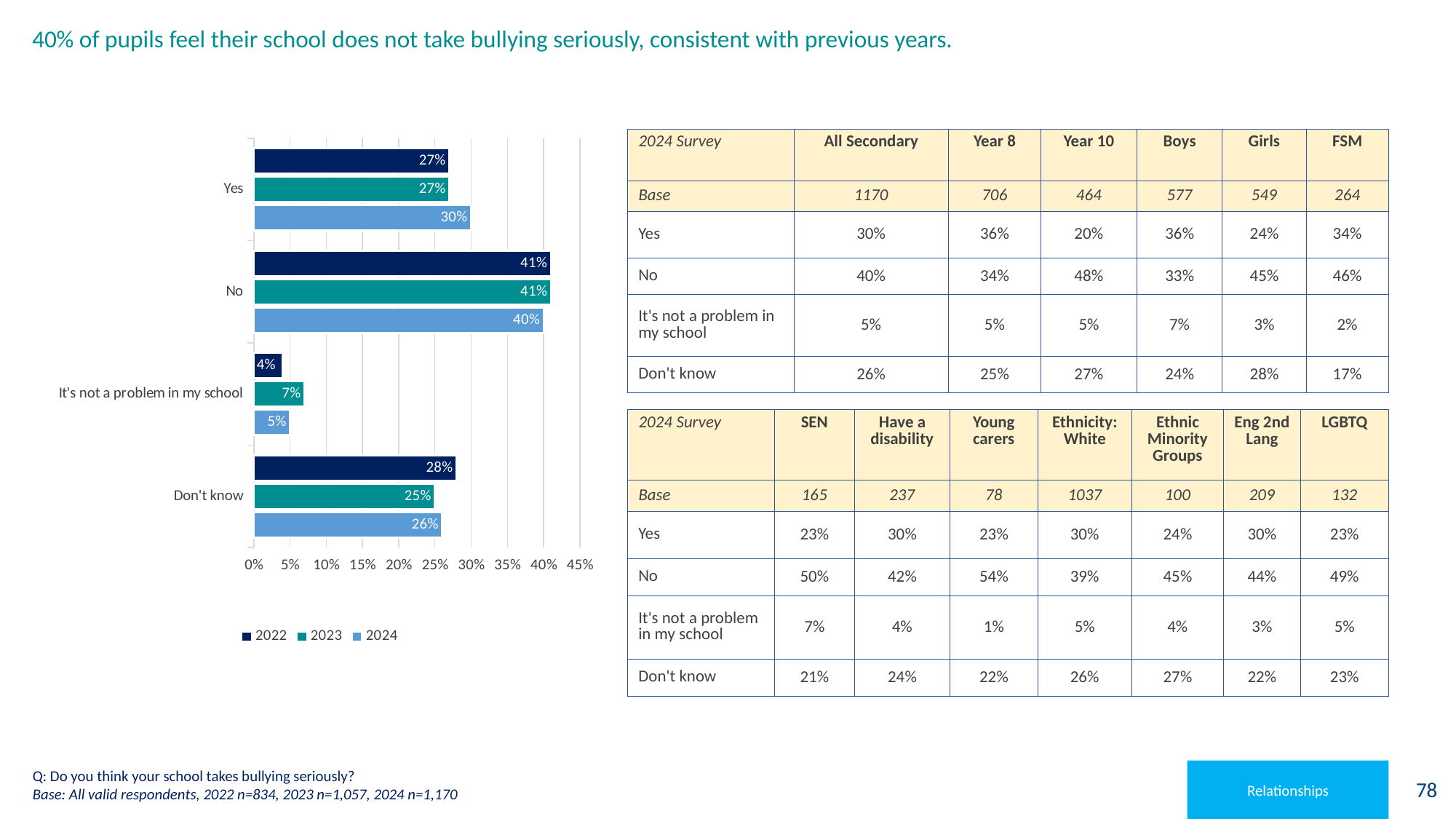
Which category has the lowest 2023 value in the bar chart? It's not a problem in my school What is the 2023 value for "Don't know" in the bar chart? 25% What is the 2024 value for "No" in the bar chart? 40% What is the difference between the 2024 and 2022 values for "Yes" in the bar chart? 3% How many categories are shown on the bar chart? 4 What is the 2022 value for "It's not a problem in my school" in the bar chart? 4% Which series does the legend of the bar chart list first? 2022 What is the 2024 value for "Yes" in the bar chart? 30% In the bar chart, is the 2022 value for "Don't know" larger or smaller than the 2024 value for "Don't know"? larger How many series does the bar chart's legend list? 3 What kind of chart is shown on the slide? bar chart Which category has the highest 2024 value in the bar chart? No